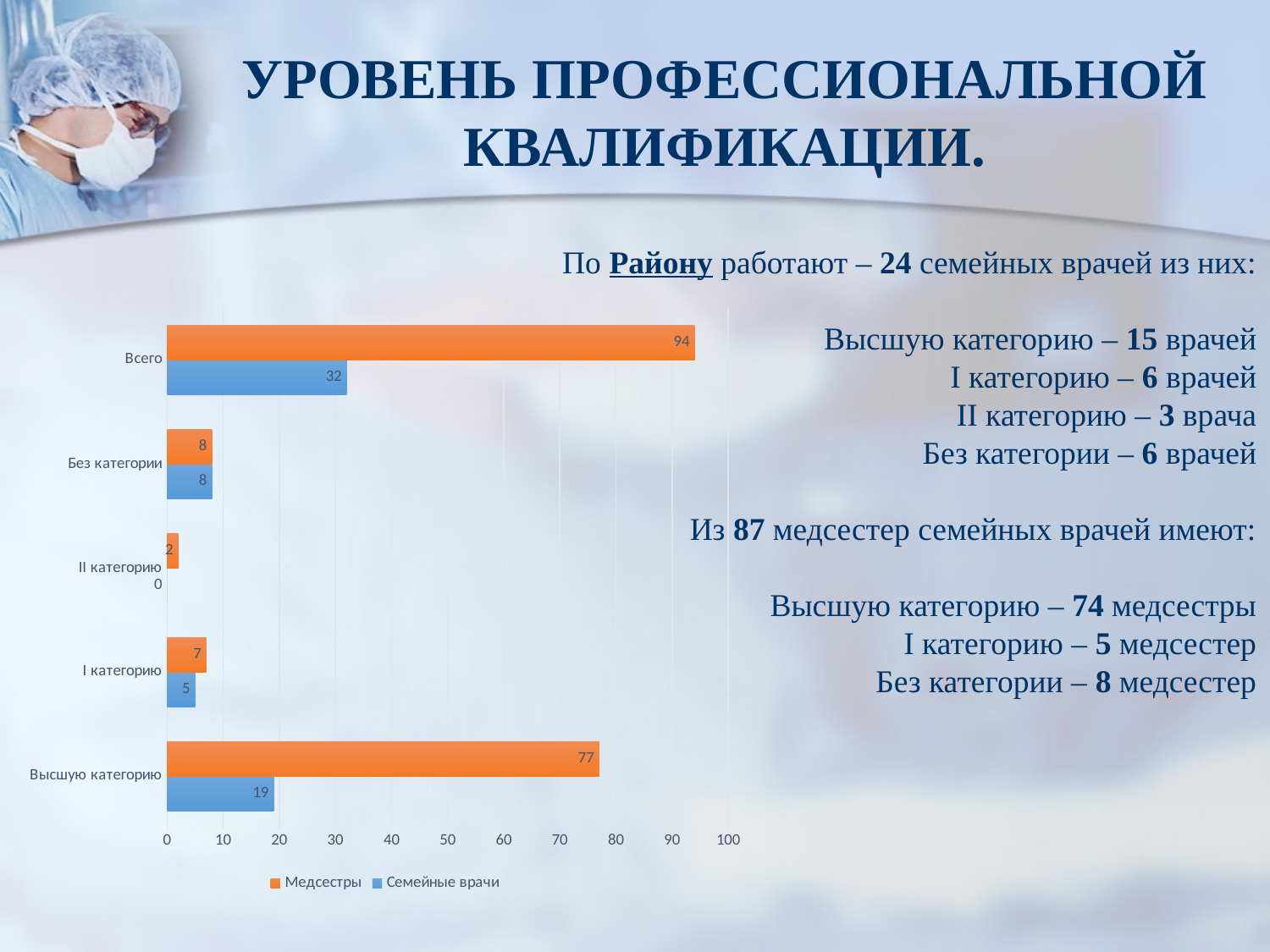
What is the difference between Медсестры and Семейные врачи in the Высшую категорию category? 58 Which colour represents the Медсестры series in the chart? orange How many series does the chart legend list? 2 What is the value for Медсестры in the Всего category? 94 What type of chart is shown on the slide? bar chart How many categories are shown on the chart's vertical axis? 5 What is the value for Семейные врачи in the Всего category? 32 Which category has the highest value for Медсестры? Всего What is the value for Семейные врачи in the I категорию category? 5 What is the value for Семейные врачи in the Высшую категорию category? 19 Which category has the lowest value for Семейные врачи? II категорию What is the value for Медсестры in the Высшую категорию category? 77